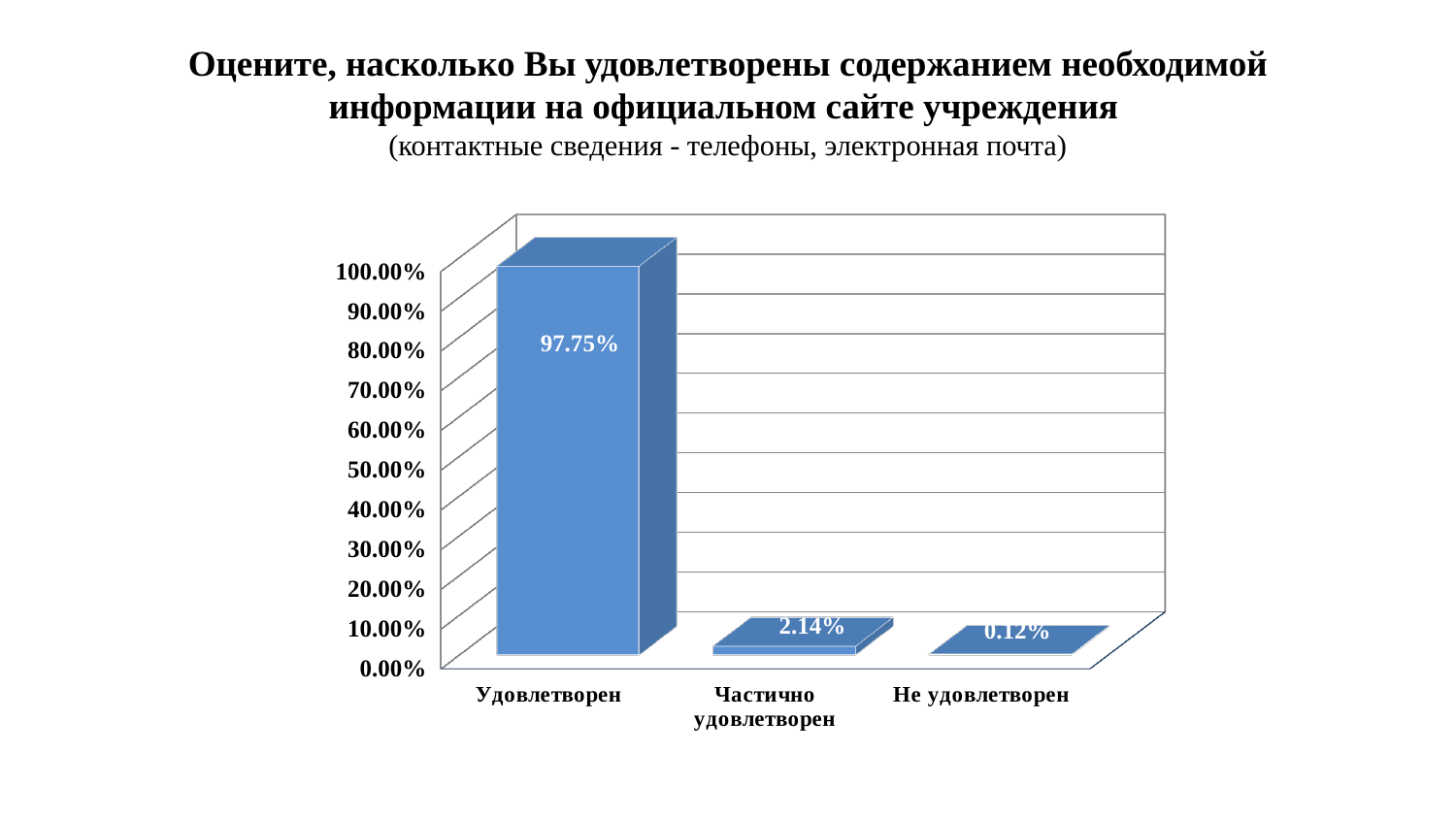
What is the value for Удовлетворен? 97.75% What kind of chart is shown on the slide? bar chart Which category has the highest value? Удовлетворен Which category has the lowest value? Не удовлетворен What is the value for Не удовлетворен? 0.12% How many categories are shown on the x axis? 3 Do the values rise or fall from left to right along the x axis? fall What is the difference between the values for Удовлетворен and Частично удовлетворен? 95.61% Which is larger, the value for Частично удовлетворен or the value for Не удовлетворен? Частично удовлетворен What is the difference between the values for Частично удовлетворен and Не удовлетворен? 2.02% Is the value for Удовлетворен greater or less than 90.00%? greater What is the value for Частично удовлетворен? 2.14%